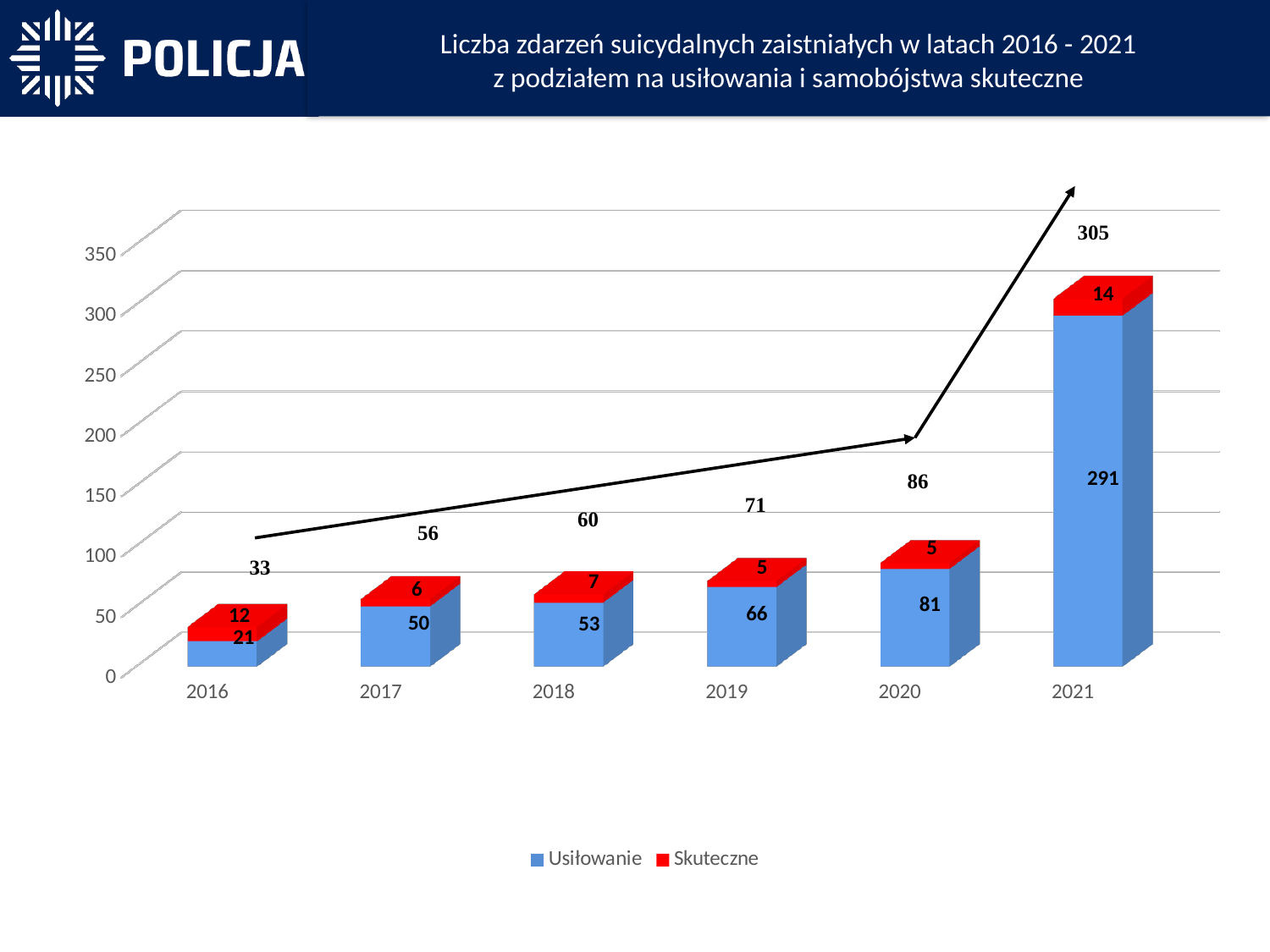
Which is larger, the Skuteczne value for 2017 or for 2018? 2018 What is the value of Usiłowanie for 2019? 66 What is the value of Usiłowanie for 2021? 291 Which year has the lowest Usiłowanie value? 2016 What is the difference between the Usiłowanie values for 2020 and 2019? 15 What is the value of Skuteczne for 2016? 12 How many series does the legend list? 2 What is the total of the stacked bar for 2016? 33 What is the total of the stacked bar for 2020? 86 How many years are shown on the x axis? 6 What kind of chart is shown on the slide? Stacked bar chart Which year has the highest Usiłowanie value? 2021